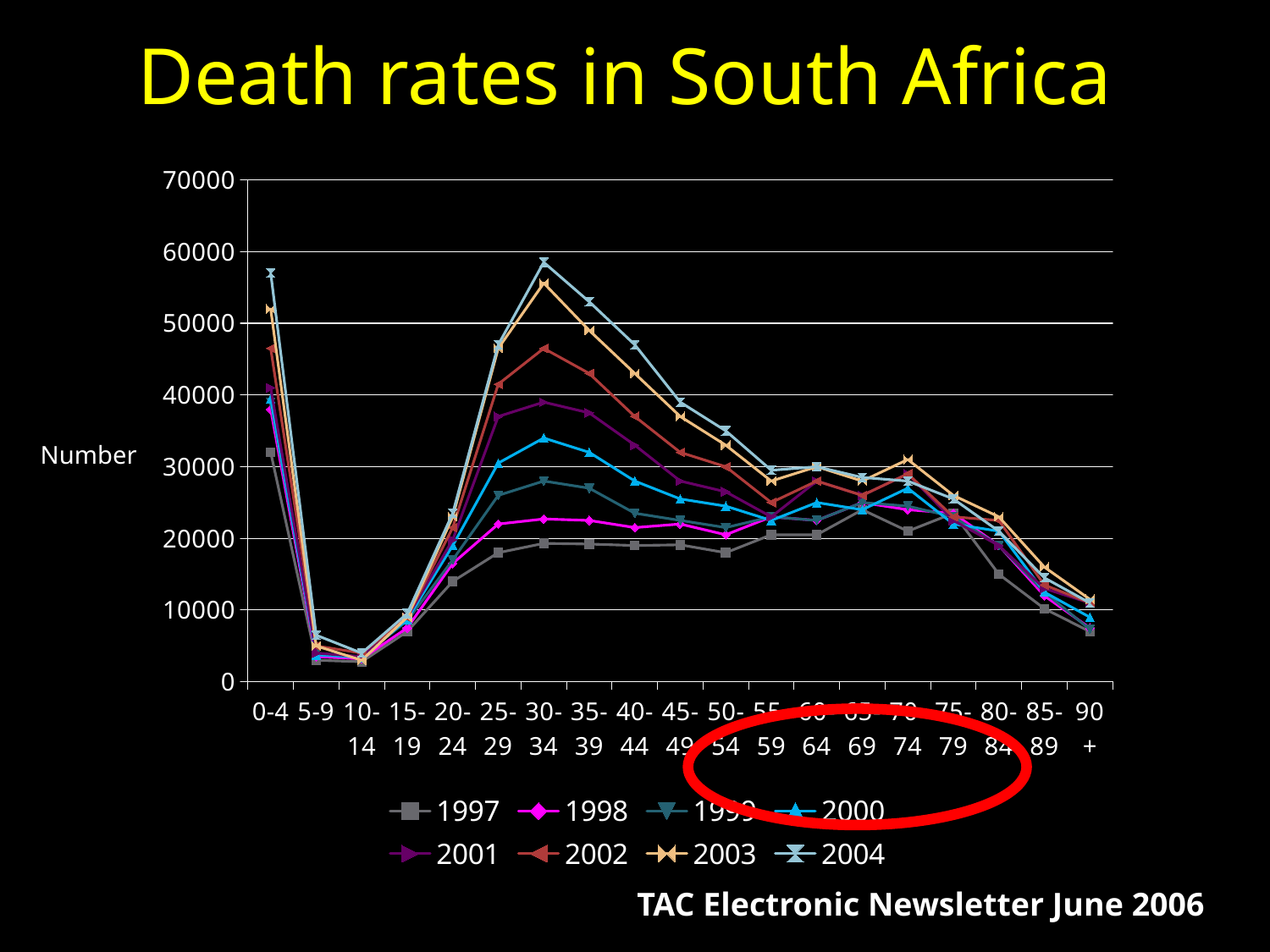
Which series has the highest value at the 30-34 age group? 2004 Is the value for 2004 at the 30-34 age group greater or less than 50000? greater How many series does the legend list? 8 Which series has the lowest value at the 30-34 age group? 1997 What kind of chart is shown on the slide? line chart For the 2003 series, which age group has the highest value? 30-34 For the 2004 series, which age group has the lowest value? 10-14 What is the title of the chart? Death rates in South Africa For the 2004 series, do the values rise or fall from the 30-34 age group to the 55-59 age group? fall Which is larger at the 35-39 age group, the 2002 value or the 2001 value? 2002 How many age-group categories are shown on the x axis? 19